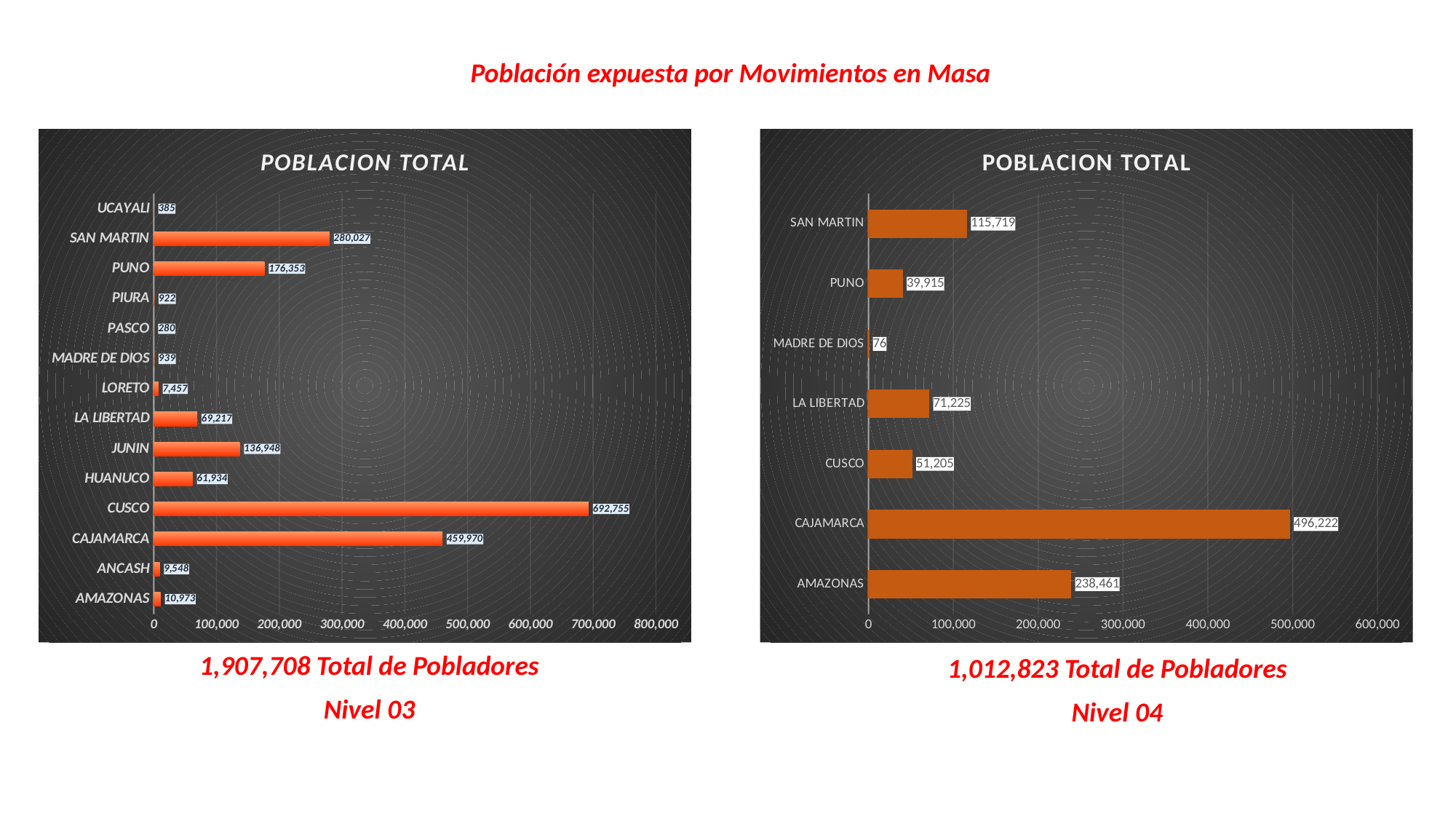
How many regions are shown in the right chart (Nivel 04)? 7 How many regions are shown in the left chart (Nivel 03)? 14 In the left chart (Nivel 03), what is the value for CUSCO? 692,755 In the right chart (Nivel 04), which region has the highest value? CAJAMARCA In the right chart (Nivel 04), what is the difference between the values for CAJAMARCA and AMAZONAS? 257,761 In the left chart (Nivel 03), which is larger, the value for SAN MARTIN or the value for PUNO? SAN MARTIN In the left chart (Nivel 03), which region has the lowest value? PASCO What type of chart is the right chart (Nivel 04)? Bar chart In the left chart (Nivel 03), what is the difference between the values for CUSCO and CAJAMARCA? 232,785 In the left chart (Nivel 03), what is the value for JUNIN? 136,948 In the right chart (Nivel 04), which region has the lowest value? MADRE DE DIOS In the right chart (Nivel 04), what is the value for SAN MARTIN? 115,719